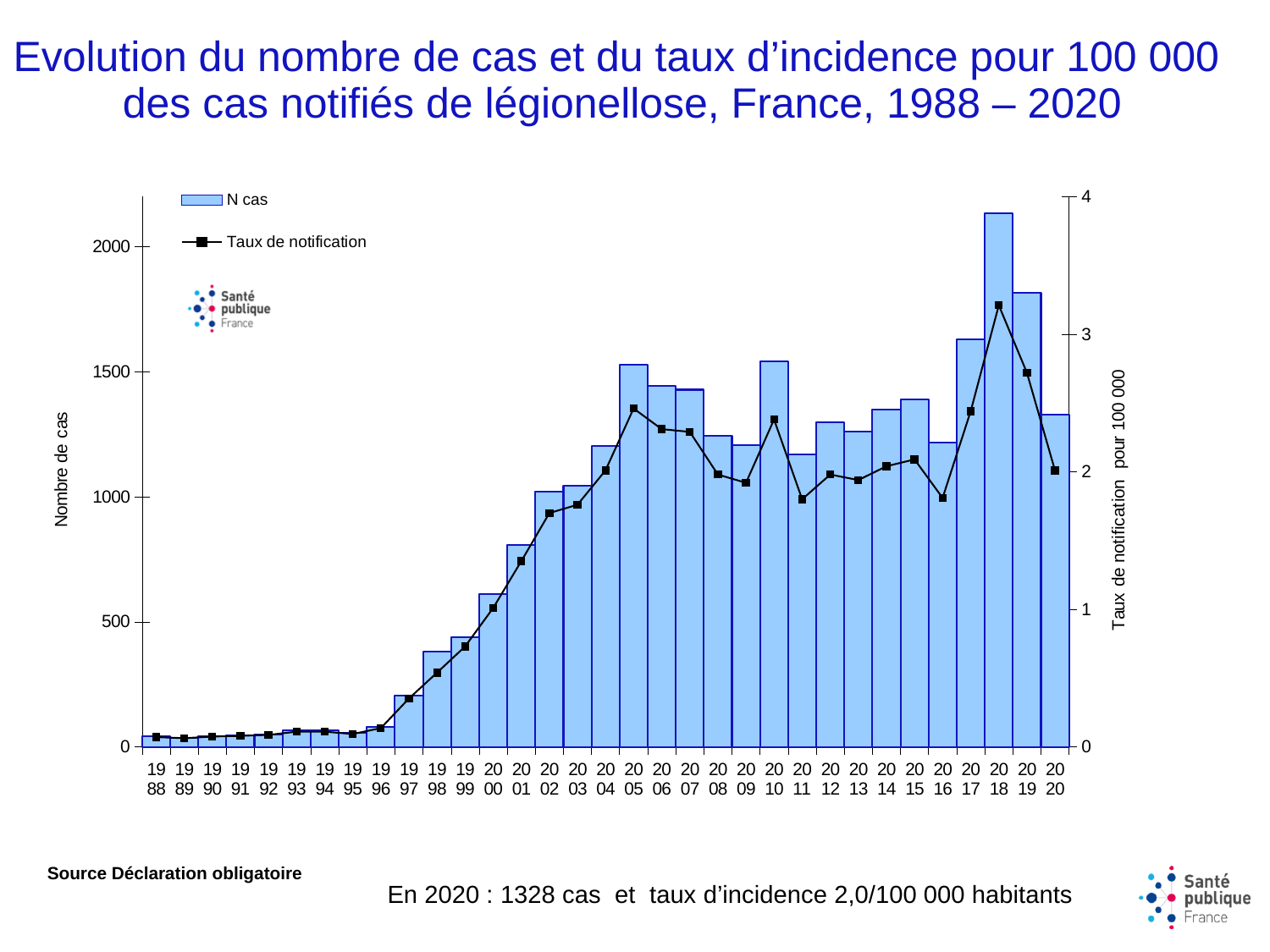
Does the number of cases rise or fall between 1996 and 2005? Rise Which year has more cases, 2018 or 2019? 2018 What kind of chart is shown on the slide? A combined bar and line chart Is the notification rate in 2011 greater or less than 2? less What are the two series named in the legend? N cas and Taux de notification Is the number of cases in 2018 greater or less than 2000? greater What is the incidence rate per 100 000 inhabitants in 2020? 2,0 How many series does the legend list? 2 What is the label of the right-hand vertical axis? Taux de notification pour 100 000 How many years are shown along the x axis? 33 How many cases were notified in 2020? 1328 Which year has the highest number of cases (tallest bar)? 2018